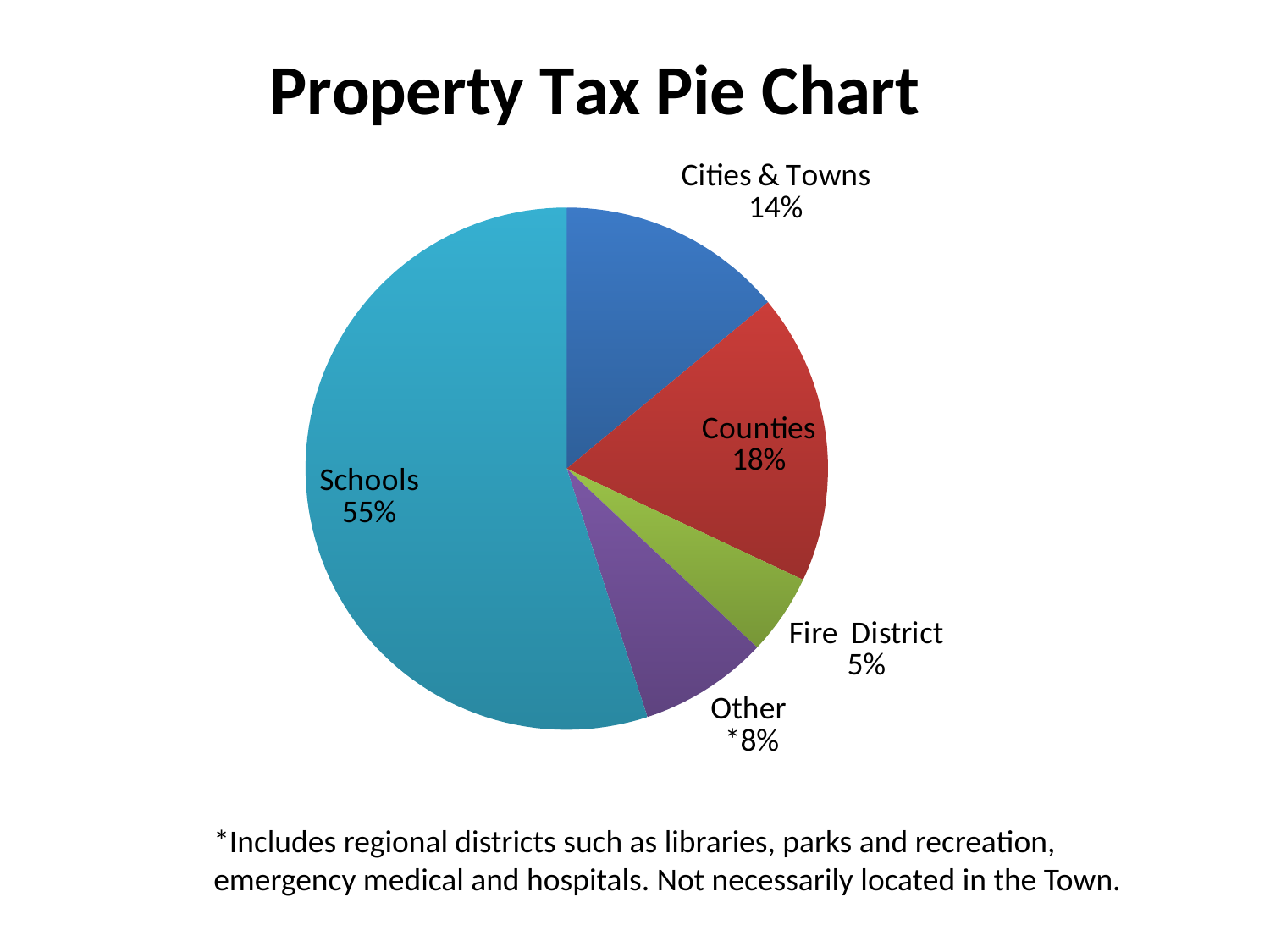
What is the difference in percentage points between Counties and Cities & Towns? 4 What is the value shown for Other? 8% What kind of chart is shown on the slide? Pie chart What is the title of the chart? Property Tax Pie Chart What is the value shown for Fire District? 5% What is the value shown for Cities & Towns? 14% What is the value shown for Counties? 18% How many slices does the pie chart have? 5 Which category has the smallest slice of the pie? Fire District Which category has the largest slice of the pie? Schools Which is larger, the slice for Other or the slice for Fire District? Other What share of the pie does Schools account for? 55%